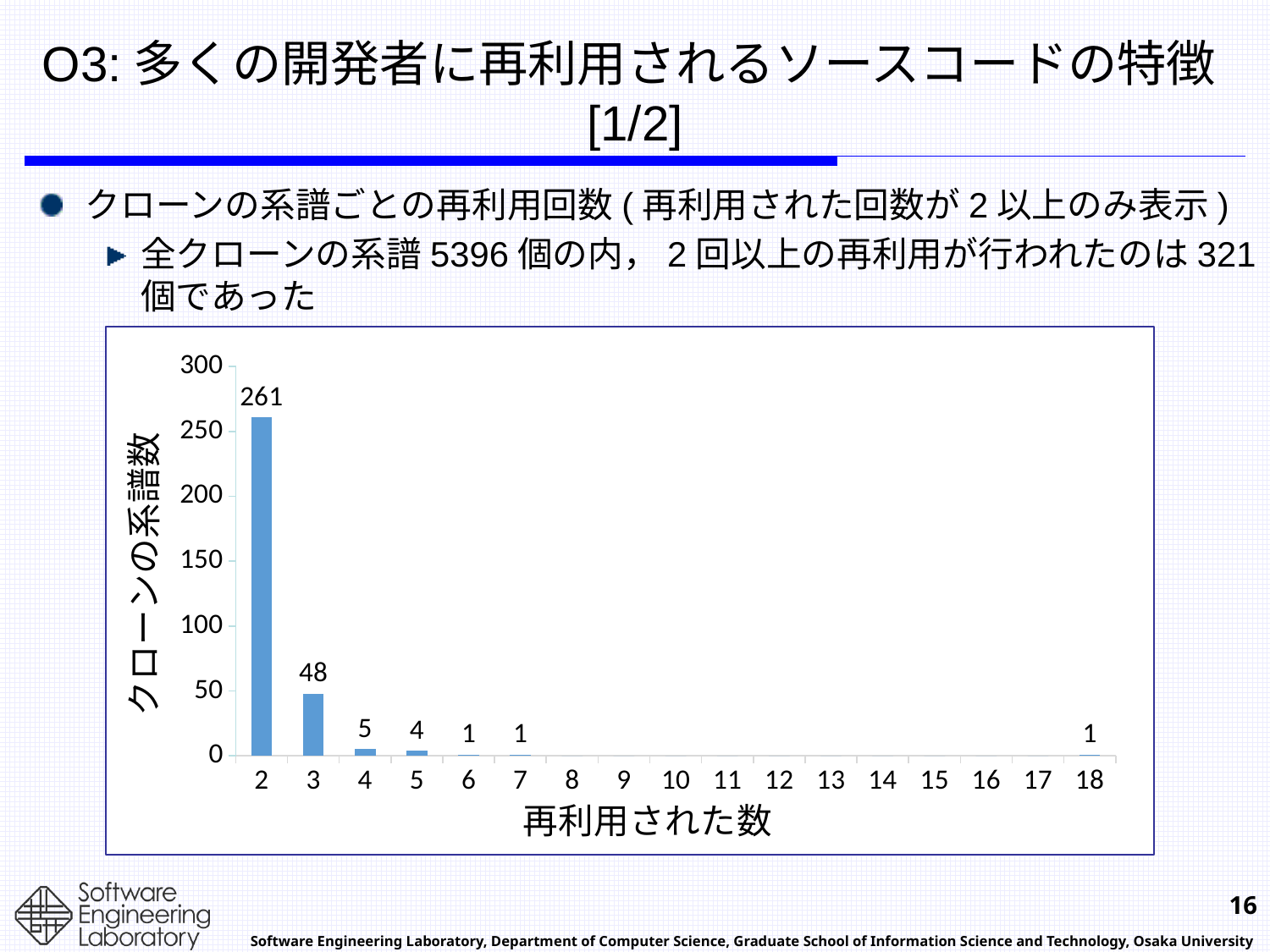
What is the value for reuse count 3? 48 What is the value for reuse count 4? 5 What is the difference between the values for reuse count 2 and reuse count 3? 213 What is the value for reuse count 2 (再利用された数 = 2)? 261 How many categories are shown on the x axis? 17 What is the value for reuse count 18? 1 Is the value for reuse count 2 greater or less than 250? greater What is the difference between the values for reuse count 4 and reuse count 5? 1 What is the label of the x axis? 再利用された数 Which reuse count category has the highest number of clone genealogies? 2 Which is larger, the value for reuse count 3 or the value for reuse count 4? reuse count 3 What kind of chart is shown on the slide? bar chart